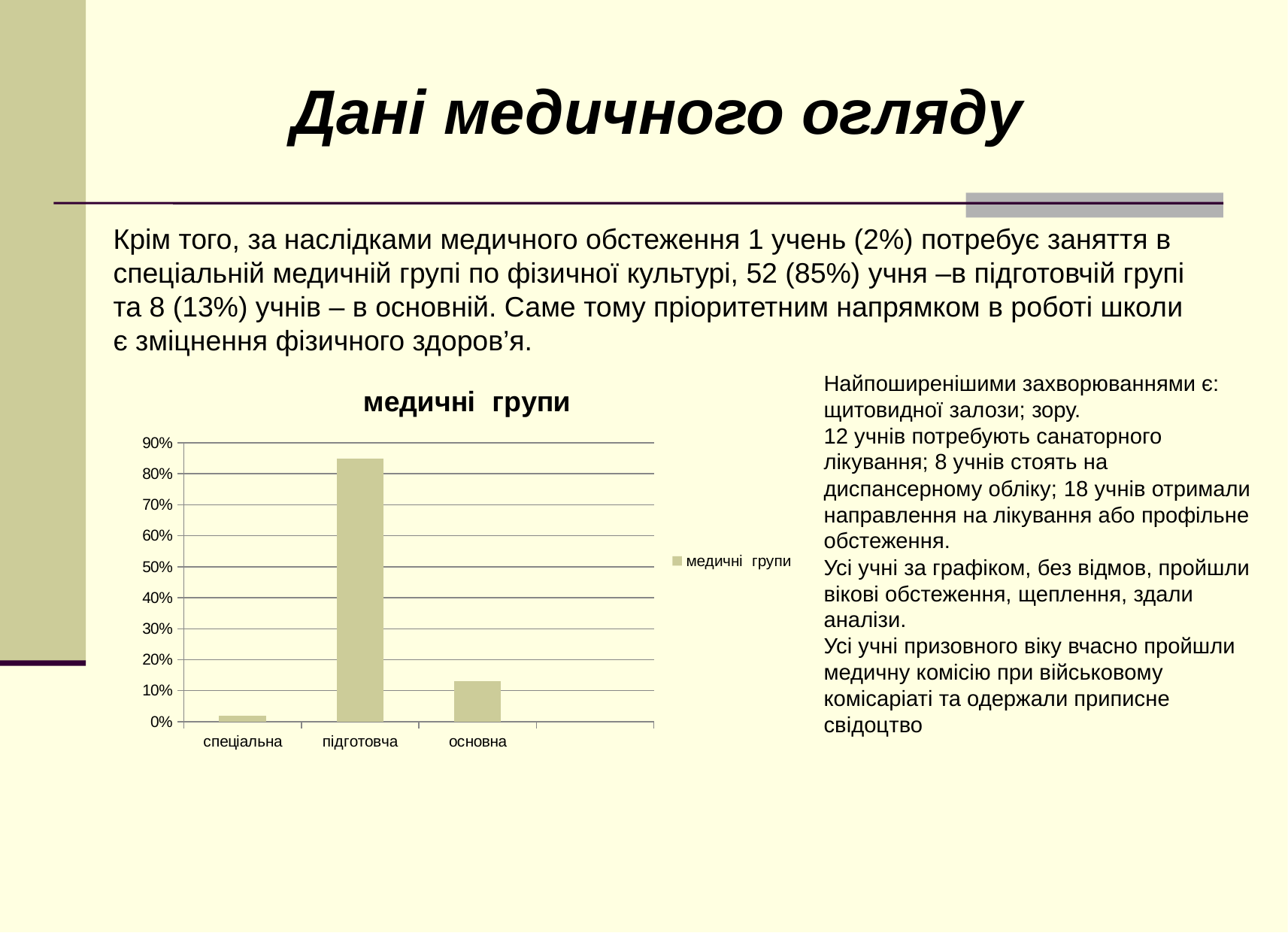
Which category has the highest bar in the chart? підготовча Which is larger, the value for підготовча or the value for основна? підготовча What kind of chart is shown on the slide? bar chart Which category has the lowest bar in the chart? спеціальна What is the title of the chart? медичні групи Is the value for спеціальна greater or less than 10%? less How many categories are shown on the x axis of the chart? 3 Which is larger, the value for основна or the value for спеціальна? основна Is the value for підготовча greater or less than 80%? greater Is the value for основна greater or less than 20%? less What is the name of the series shown in the chart legend? медичні групи How many series does the chart legend list? 1